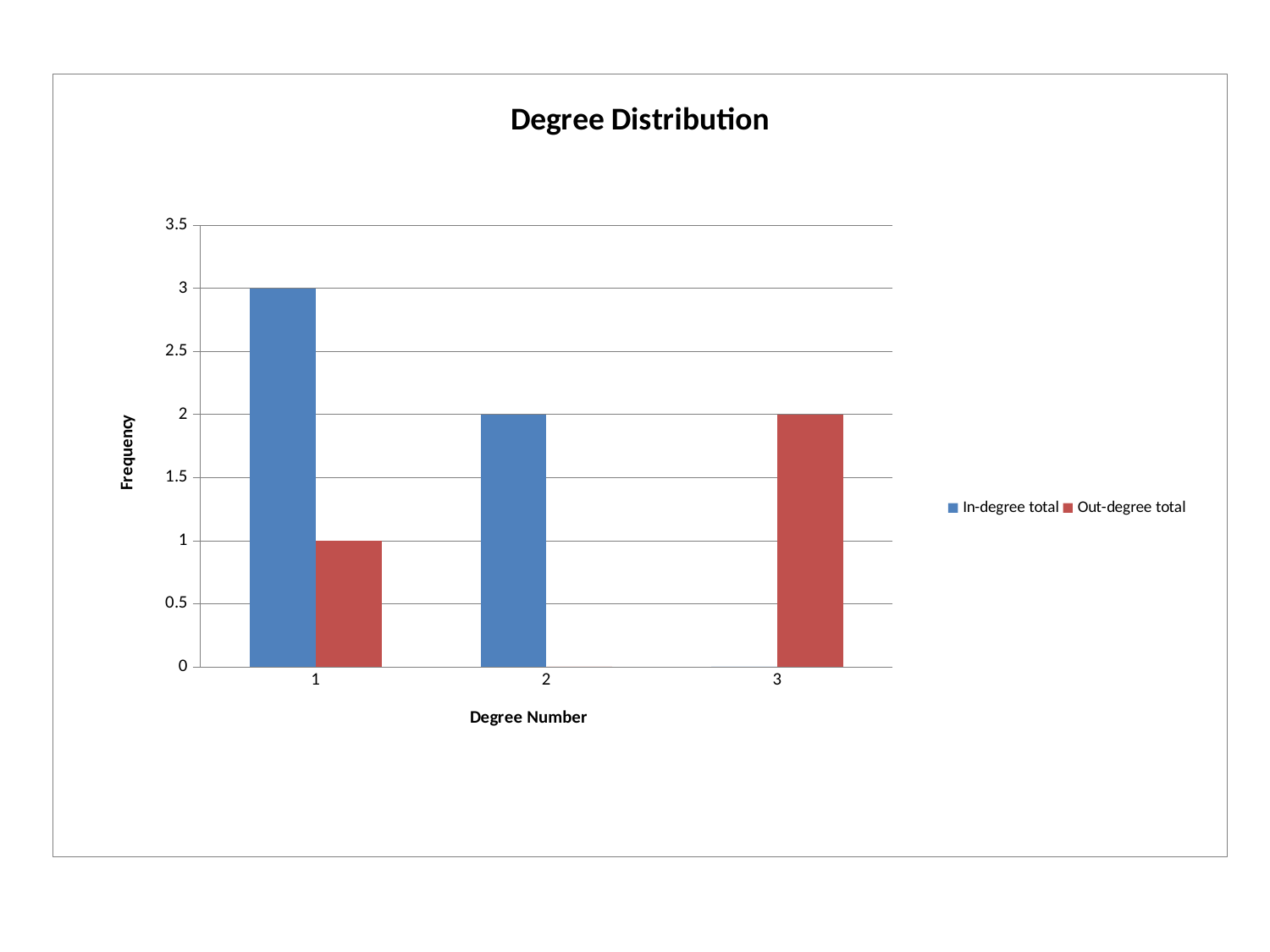
What is the difference between the In-degree total and the Out-degree total for degree number 1? 2 What type of chart is shown on the slide? bar chart Which series is shown in red? Out-degree total What is the Out-degree total frequency for degree number 1? 1 What is the title of the chart? Degree Distribution For degree number 1, which is larger, the In-degree total or the Out-degree total? In-degree total Which degree number has the highest In-degree total? 1 How many series does the legend list? 2 What is the Out-degree total frequency for degree number 3? 2 What is the In-degree total frequency for degree number 2? 2 How many degree number categories are shown on the x axis? 3 What is the In-degree total frequency for degree number 1? 3